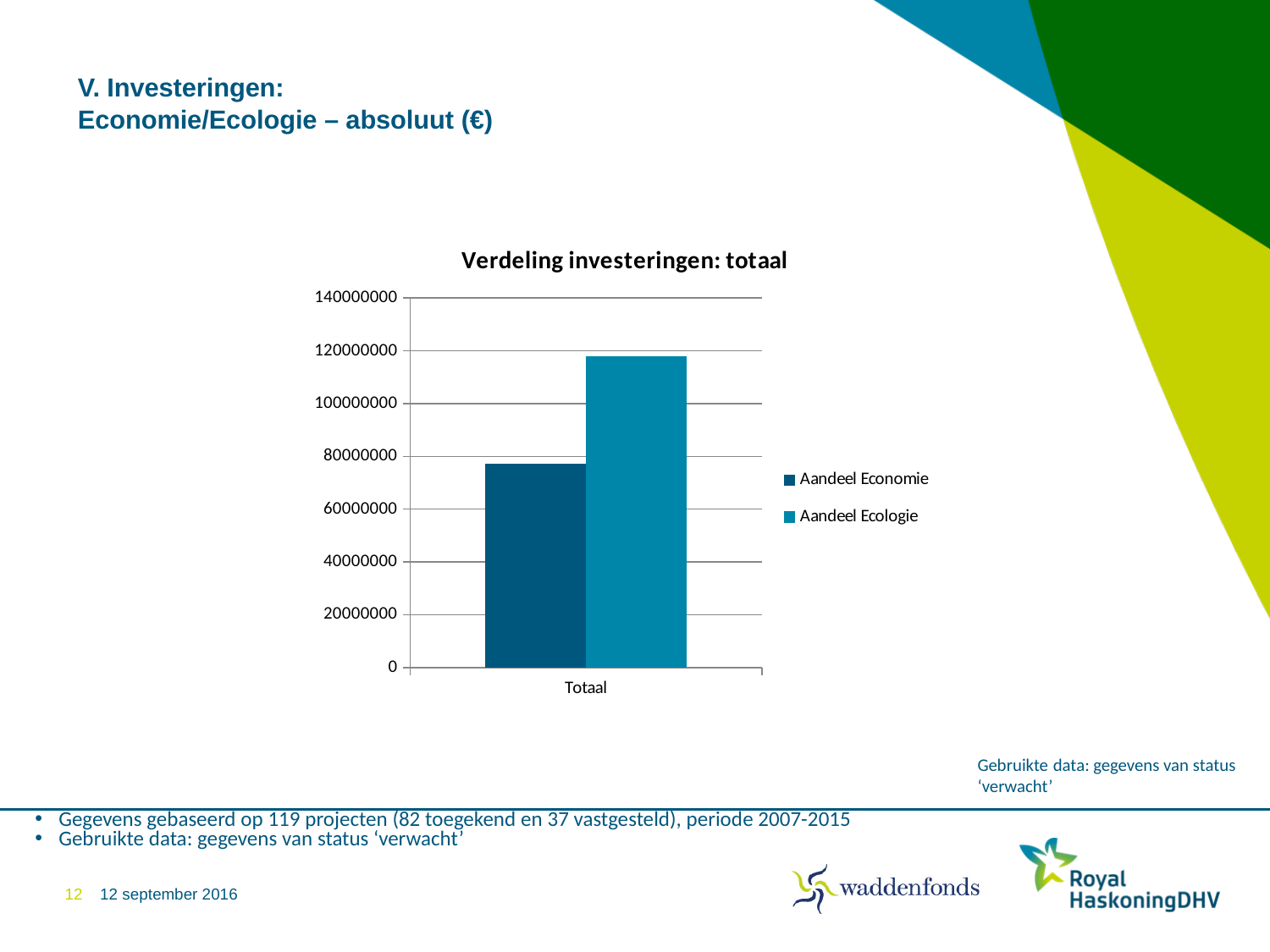
What is the label of the single category on the x axis? Totaal Which is larger for Totaal: Aandeel Economie or Aandeel Ecologie? Aandeel Ecologie Is the value for Aandeel Economie greater or less than 60000000? greater Is the value for Aandeel Economie greater or less than 80000000? less Which series has the lowest value for Totaal? Aandeel Economie Is the value for Aandeel Ecologie greater or less than 100000000? greater How many series does the legend list? 2 Which series has the highest value for Totaal? Aandeel Ecologie How many categories are shown on the x axis? 1 What kind of chart is shown on the slide? bar chart What is the title of the chart? Verdeling investeringen: totaal